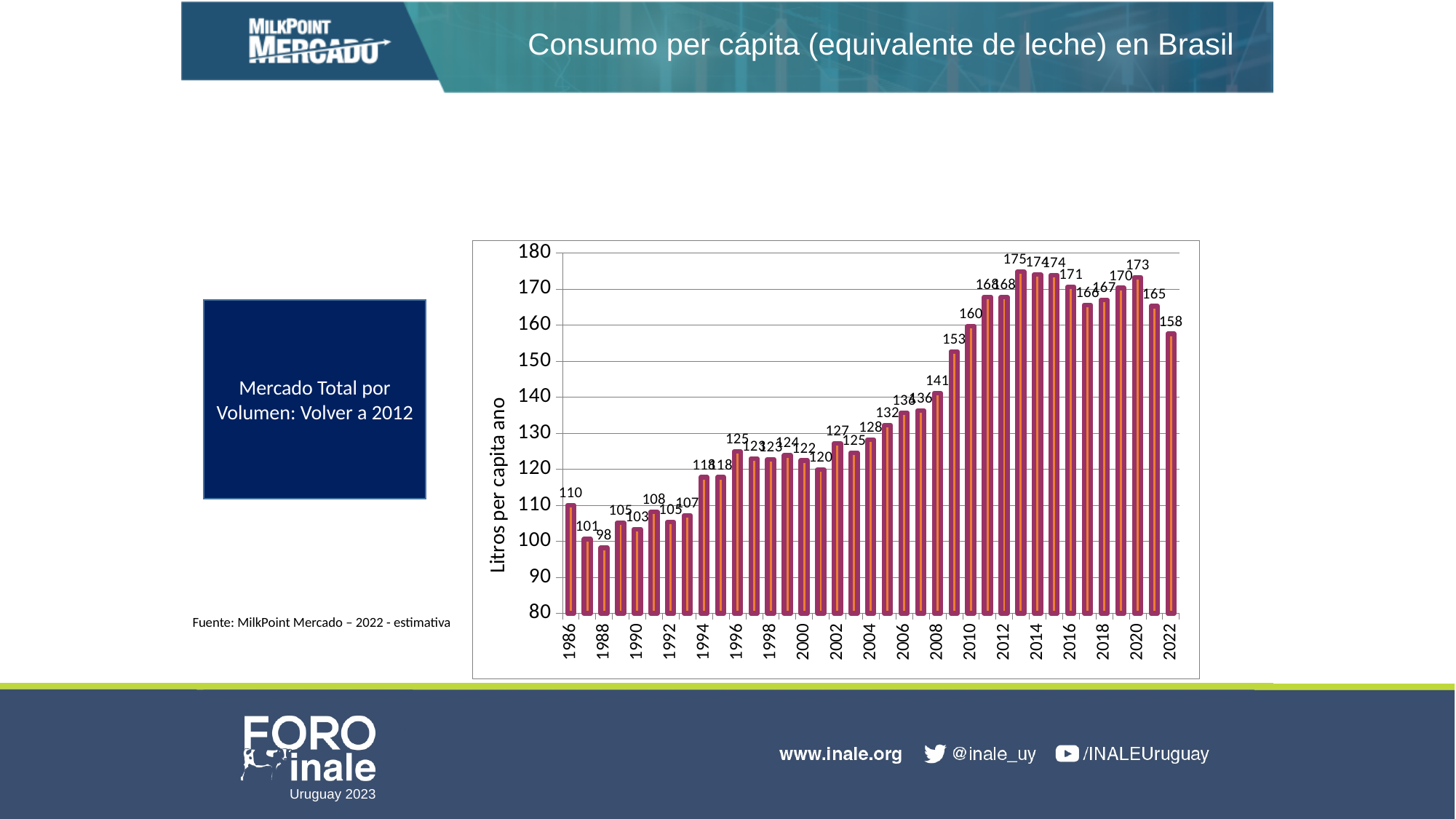
Do the values rise or fall from 2020 to 2022? fall What is the difference between the values for 2010 and 2000? 38 Is the value for 2008 greater or less than 150? less What is the value shown for 2010? 160 What is the highest value labelled on any bar in the chart? 175 Which year has the larger value, 2012 or 2016? 2016 What is the per capita consumption value shown for 1986? 110 What is the value shown for 2022? 158 What is the difference between the values for 2020 and 2022? 15 What kind of chart is shown on the slide? bar chart Which year has the lowest value in the chart? 1988 How many bars (years) are plotted in the chart? 37